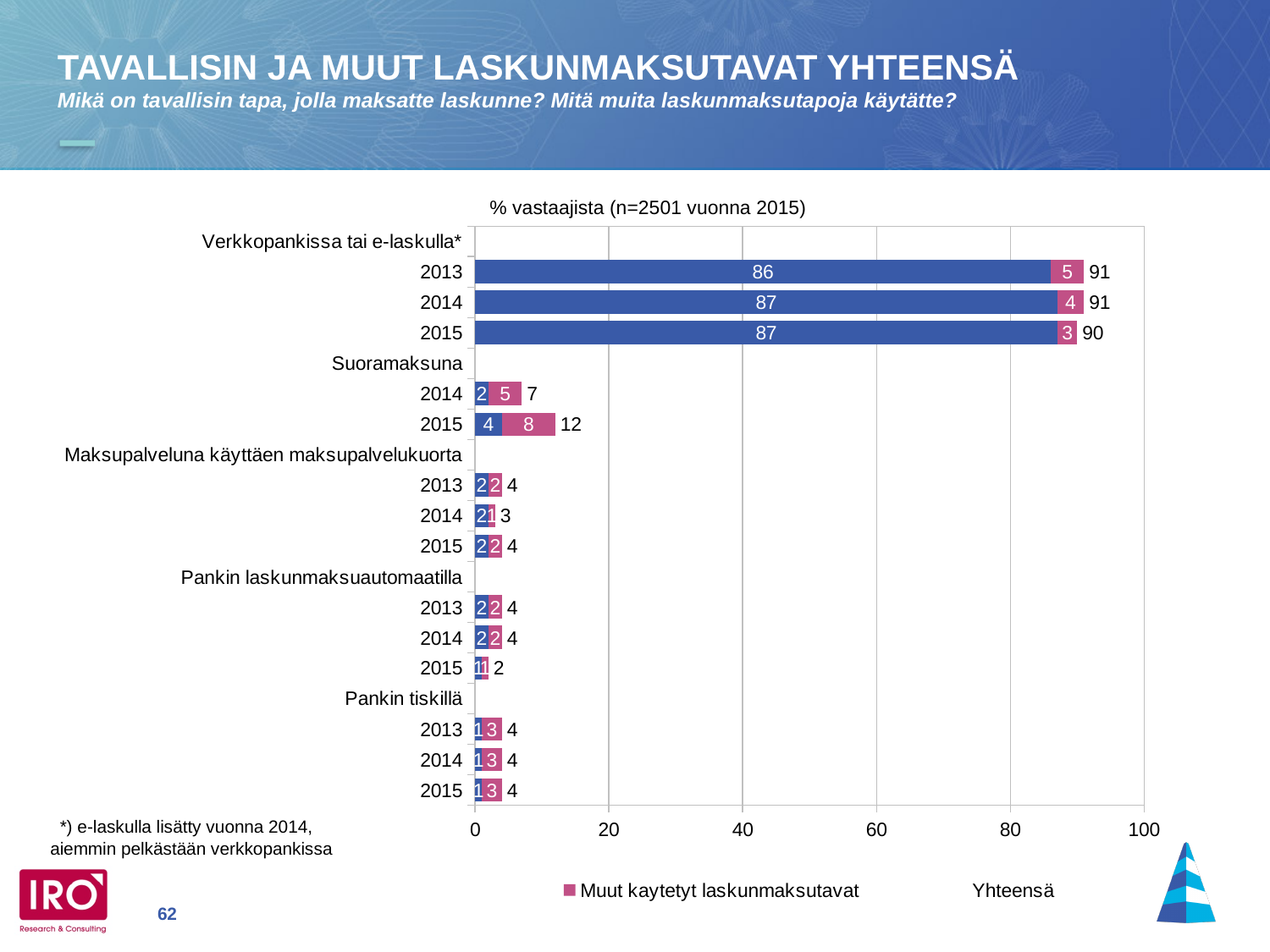
What type of chart is shown on the slide? Stacked bar chart What is the total (Yhteensä) value for Verkkopankissa tai e-laskulla in 2015? 90 What is the pink (Muut kaytetyt laskunmaksutavat) value for Suoramaksuna in 2015? 8 Which payment method has the lowest total value in 2015? Pankin laskunmaksuautomaatilla Which payment method has the highest total value in 2015? Verkkopankissa tai e-laskulla* What is the sample size stated in the chart's subtitle for 2015? n=2501 Is the total for Suoramaksuna in 2015 larger than the total for Pankin tiskillä in 2015? Yes How many payment method categories are shown in the chart? 5 Is the blue segment value for Verkkopankissa tai e-laskulla in 2014 greater or less than 80? greater What is the blue segment value for Verkkopankissa tai e-laskulla in 2013? 86 What is the difference between the Suoramaksuna totals for 2015 and 2014? 5 What is the total value for Suoramaksuna in 2014? 7